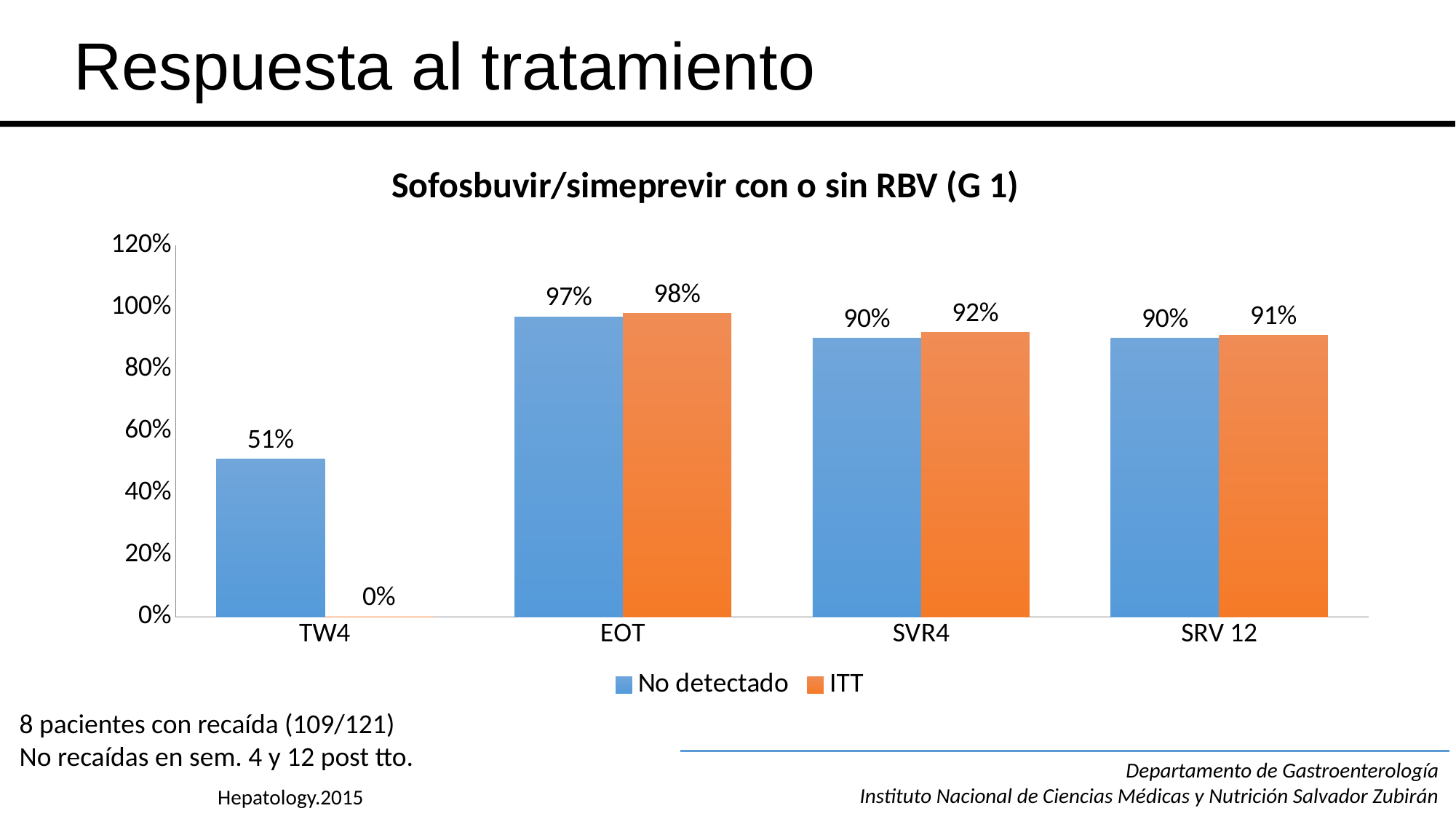
At which category is the ITT value lowest? TW4 What type of chart is shown? Bar chart What is the value for No detectado at TW4? 51% At which category is the No detectado value highest? EOT What is the value for No detectado at SVR4? 90% How many series does the legend list? 2 What is the value for ITT at TW4? 0% How many categories are shown on the x axis? 4 Which is larger at EOT, No detectado or ITT? ITT What is the difference between the ITT and No detectado values at SVR4? 2% What is the value for ITT at EOT? 98% What is the value for ITT at SRV 12? 91%